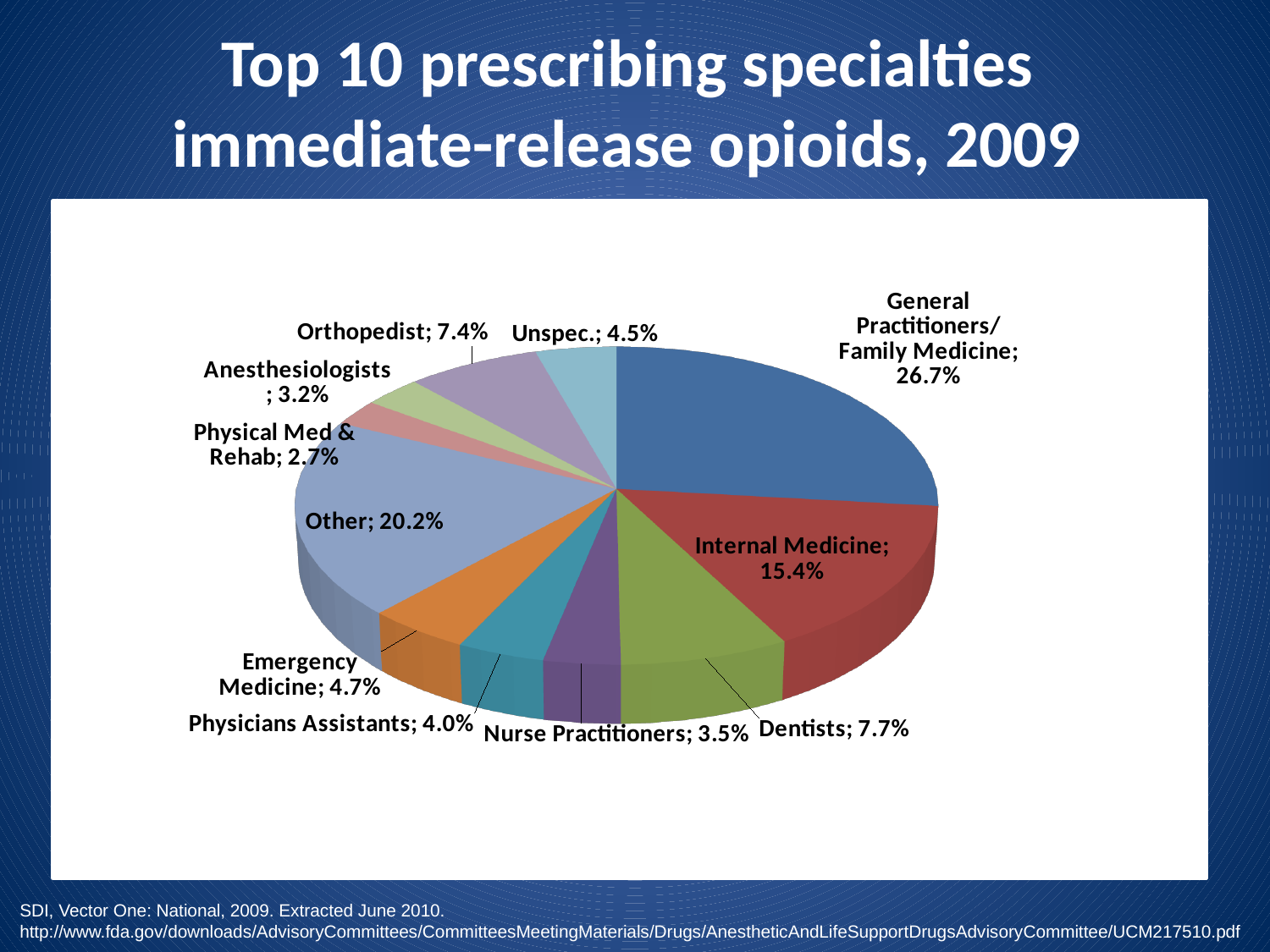
What is the value for Physical Med & Rehab? 2.7% How many slices does the pie chart have? 11 What share of the pie is General Practitioners/Family Medicine? 26.7% What is the title of the slide containing the chart? Top 10 prescribing specialties immediate-release opioids, 2009 Which category has the smallest slice of the pie? Physical Med & Rehab What is the value for Internal Medicine? 15.4% What kind of chart is shown on the slide? pie chart Which is larger, Emergency Medicine or Physicians Assistants? Emergency Medicine Which specialty has the largest slice of the pie? General Practitioners/Family Medicine What is the value for Dentists? 7.7% Which is larger, the Orthopedist slice or the Dentists slice? Dentists What is the difference between the General Practitioners/Family Medicine share and the Internal Medicine share? 11.3%